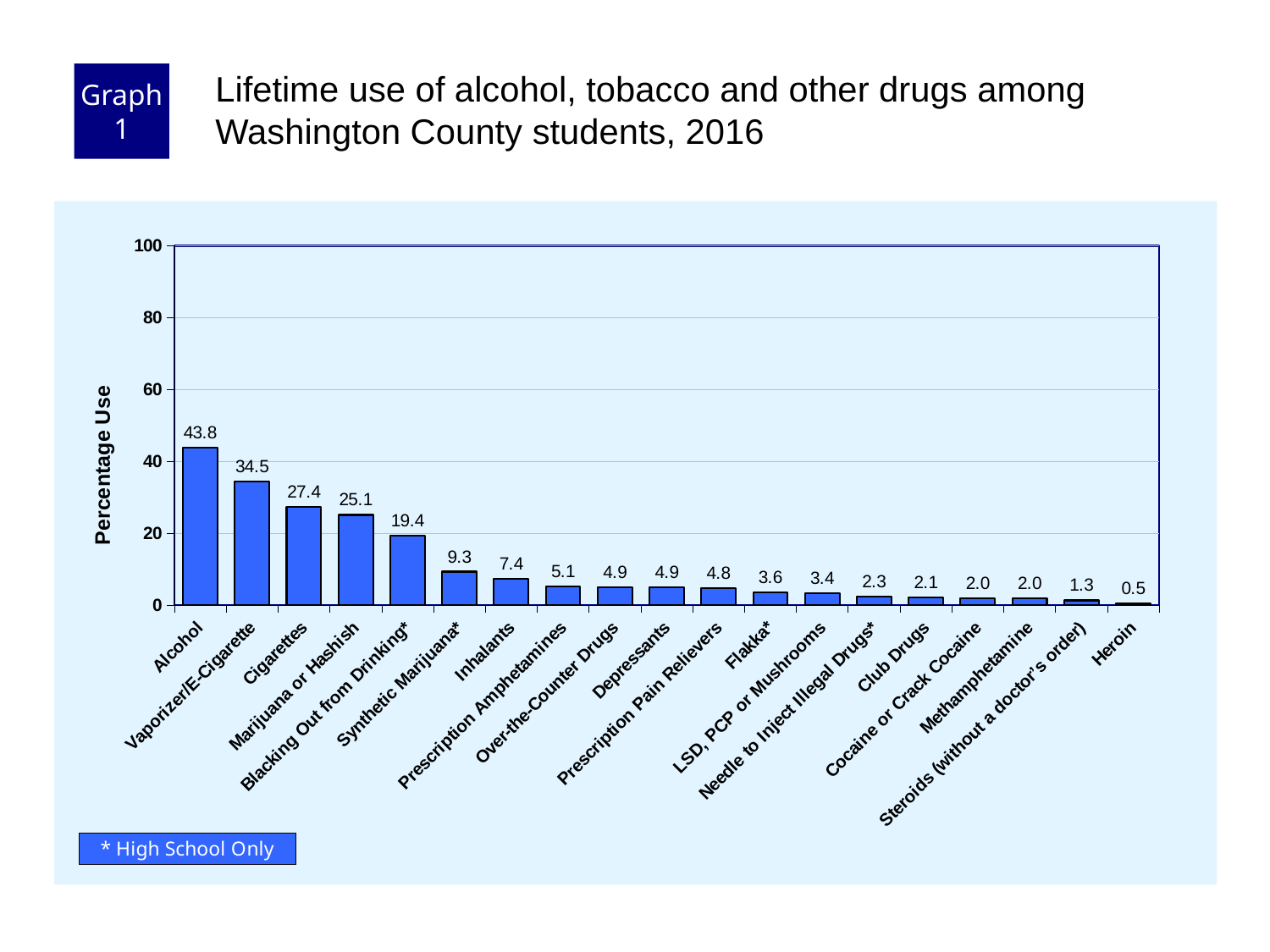
What is the value for Synthetic Marijuana*? 9.3 What value is shown for Vaporizer/E-Cigarette? 34.5 Which category has the lowest lifetime use percentage? Heroin How many categories are shown on the x axis? 19 Which category has the highest lifetime use percentage? Alcohol What is the difference between the values for Alcohol and Cigarettes? 16.4 What is the lifetime use percentage for Alcohol? 43.8 Do the values rise or fall moving from left to right along the x axis? Fall What is the label of the y axis? Percentage Use Which is larger, the value for Marijuana or Hashish or the value for Blacking Out from Drinking*? Marijuana or Hashish What value is shown for Heroin? 0.5 What kind of chart is shown on the slide? Bar chart